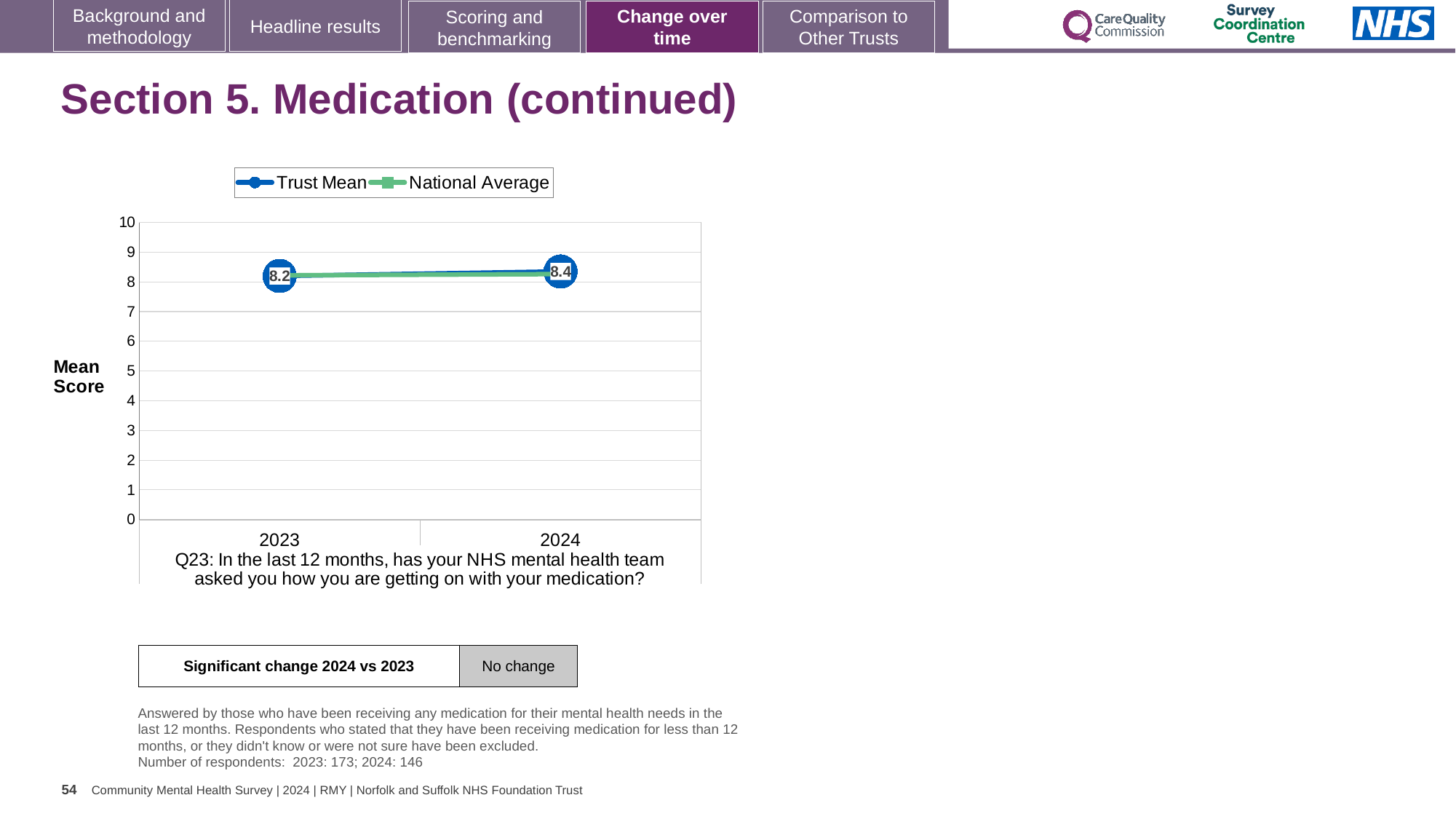
In which year is the Trust Mean lower? 2023 In which year is the Trust Mean higher? 2024 How many years are shown on the x axis of the chart? 2 By how much did the Trust Mean change from 2023 to 2024? 0.2 Does the Trust Mean rise or fall from 2023 to 2024? rise What is the Trust Mean score for 2023? 8.2 Is the National Average value for 2023 greater or less than 7? greater What kind of chart is shown on the slide? line chart What is the label on the y axis of the chart? Mean Score Is the Trust Mean for 2024 larger or smaller than the Trust Mean for 2023? larger What is the Trust Mean score for 2024? 8.4 How many series does the chart legend list? 2